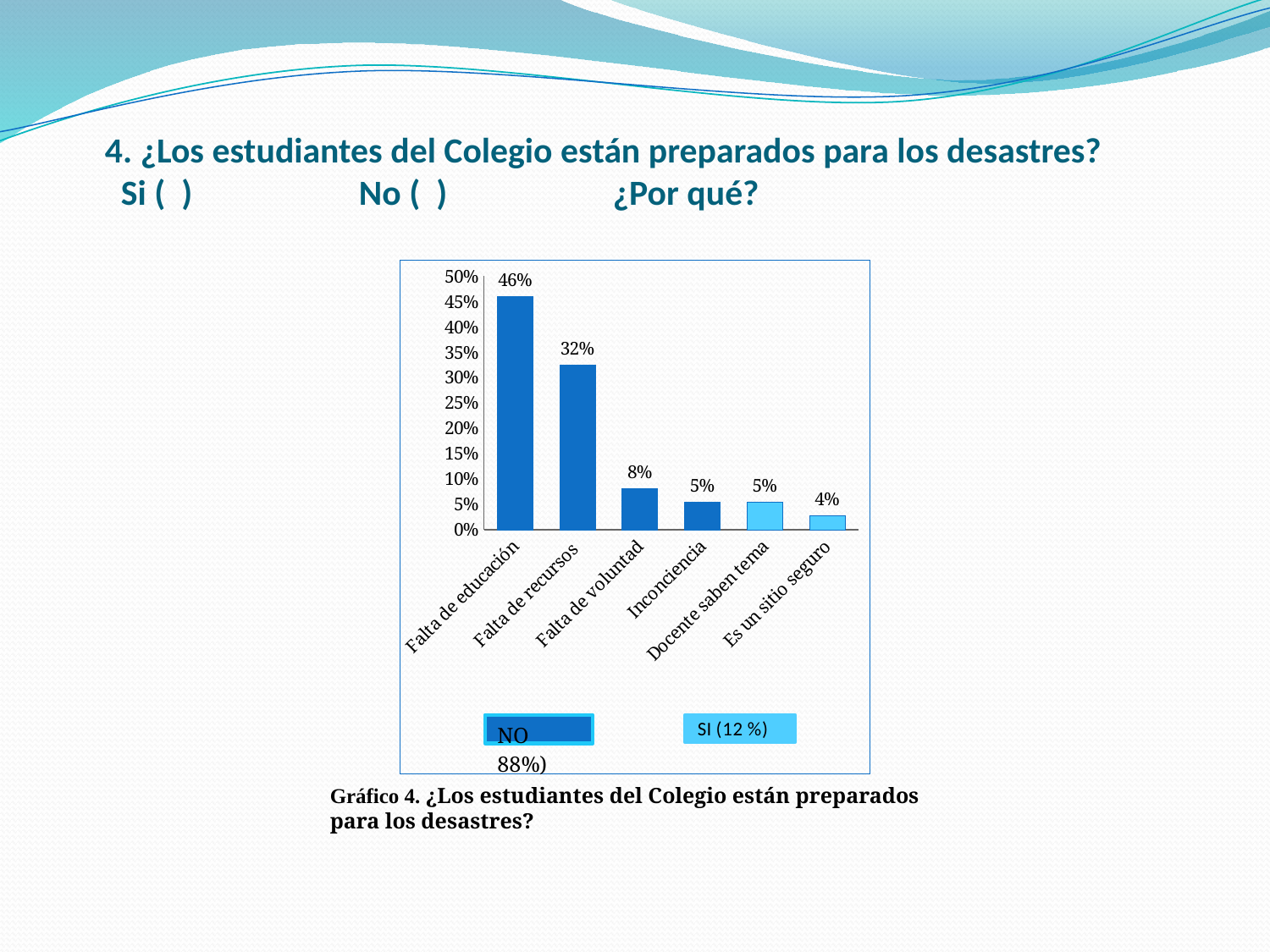
Which is larger, the value for Falta de voluntad or the value for Inconciencia? Falta de voluntad How many categories are shown on the x axis? 6 What is the value for Falta de recursos? 32% Which category has the highest value? Falta de educación What is the value for Falta de voluntad? 8% What is the value for Falta de educación? 46% How many entries does the legend list? 2 What is the difference between the values for Falta de educación and Falta de recursos? 14% What percentage does the legend give for the NO group? 88% What is the value for Es un sitio seguro? 4% Which category has the lowest value? Es un sitio seguro What kind of chart is shown on the slide? Bar chart